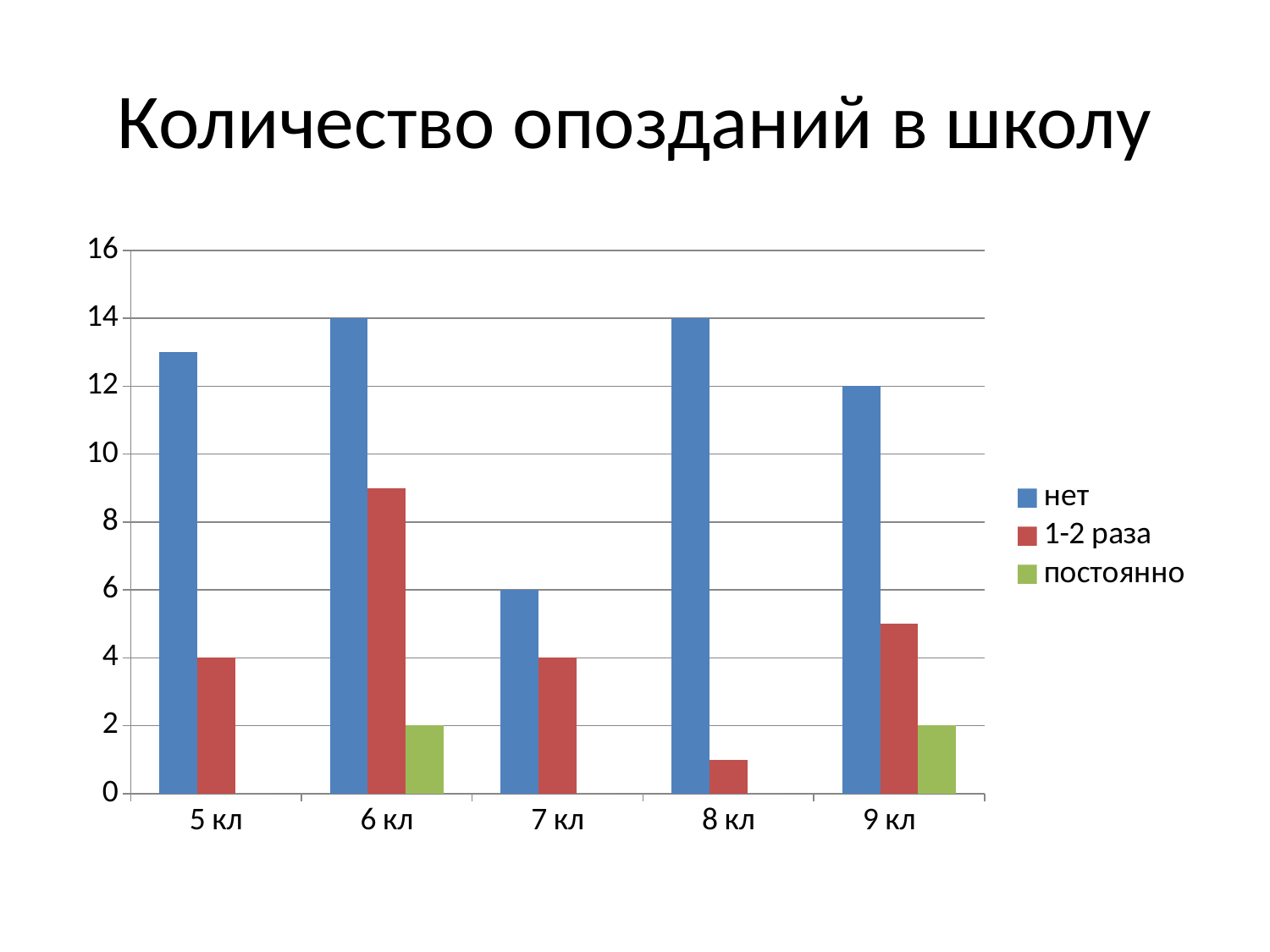
What is the value of the 'постоянно' series for 9 кл? 2 How many class categories are shown on the x axis? 5 What is the value of the '1-2 раза' series for 5 кл? 4 What is the difference between the 'нет' values for 6 кл and 7 кл? 8 What is the value of the 'нет' series for 6 кл? 14 Which class has the lowest value in the 'нет' series? 7 кл How many series does the legend list? 3 Which class has the highest value in the '1-2 раза' series? 6 кл What is the title of the chart? Количество опозданий в школу What kind of chart is shown on the slide? bar chart What is the value of the 'нет' series for 7 кл? 6 Is the '1-2 раза' value for 8 кл greater or less than 2? less